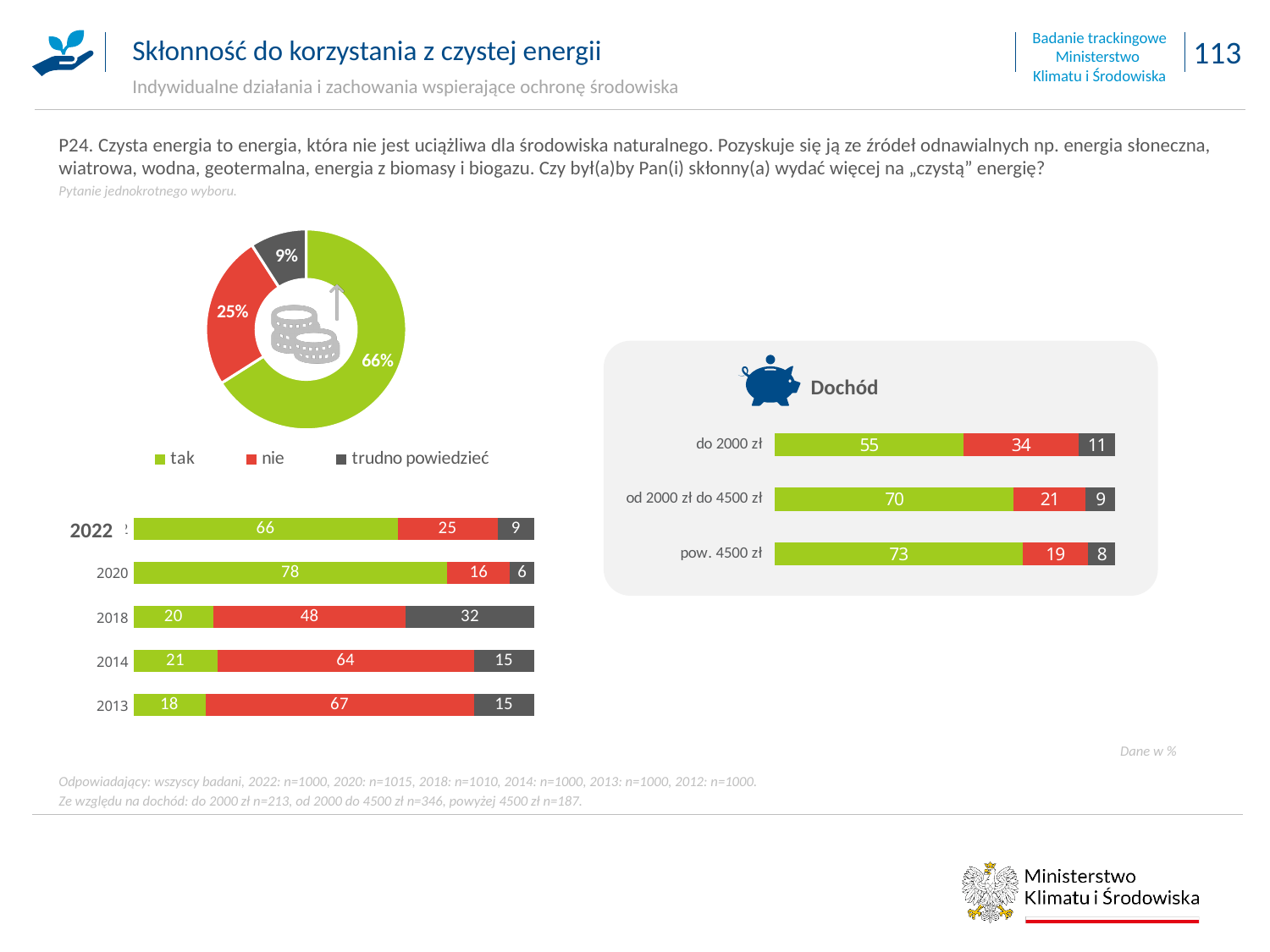
In the bar chart by year at the bottom left, which year has the highest value for "tak"? 2020 In the bar chart by year at the bottom left, what is the value for "nie" in 2013? 67 What type of chart is the "Dochód" chart on the right? stacked bar chart How many entries does the legend of the donut chart at the top left list? 3 In the donut chart at the top left, which answer has the smallest share? trudno powiedzieć In the bar chart by year at the bottom left, what is the value for "tak" in 2020? 78 In the "Dochód" chart on the right, which income group has the highest value for "nie"? do 2000 zł In the donut chart at the top left, what share of respondents answered "trudno powiedzieć"? 9% How many years are shown in the bar chart at the bottom left? 5 In the "Dochód" chart on the right, what is the value for "tak" for "pow. 4500 zł"? 73 In the bar chart by year at the bottom left, what is the difference between the "tak" values for 2020 and 2022? 12 In the donut chart at the top left, what share of respondents answered "tak"? 66%